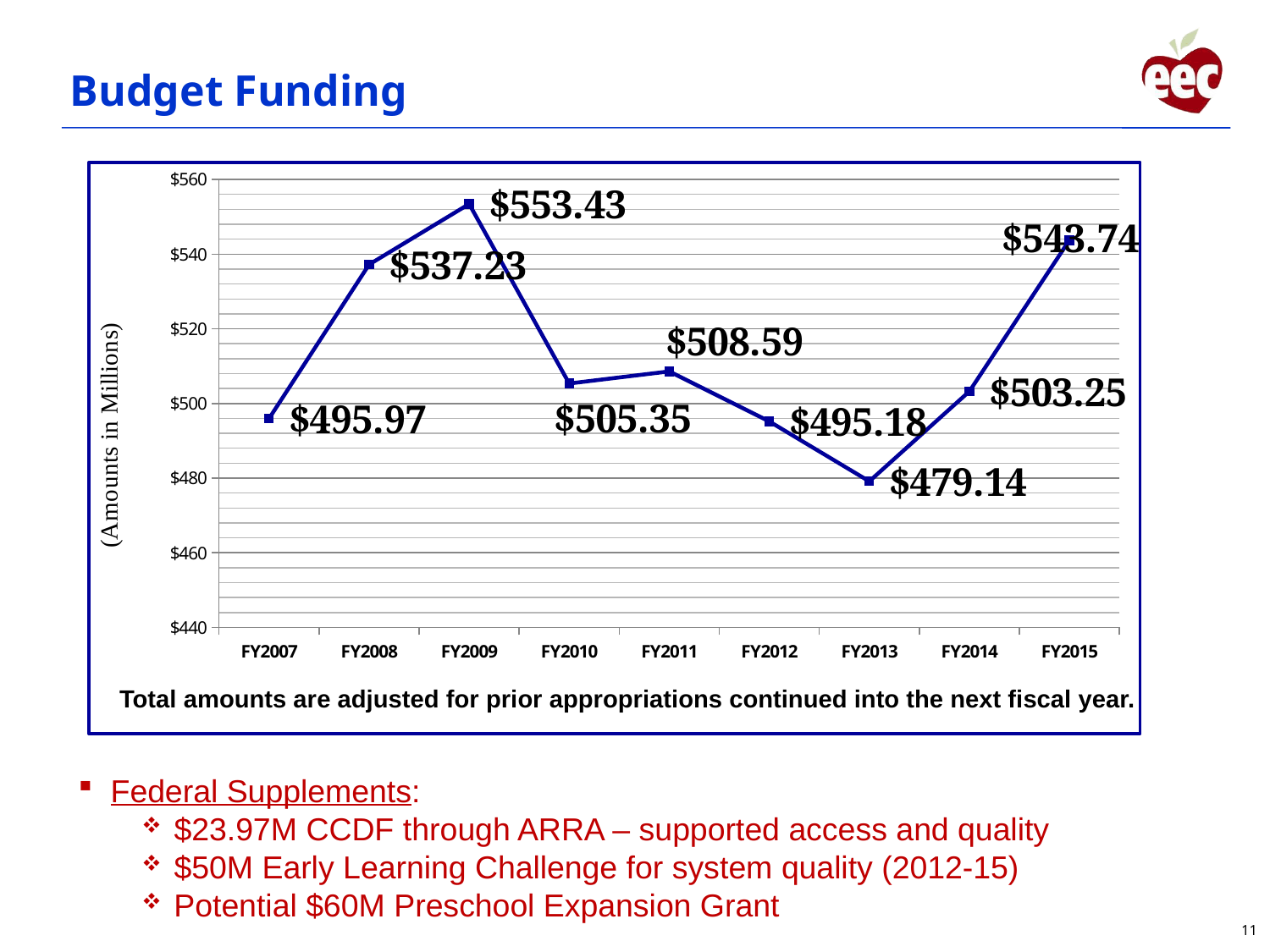
What is the difference between the FY2009 and FY2008 values? $16.20 Do the values rise or fall from FY2009 to FY2013? fall How many fiscal years are plotted on the chart? 9 What is the budget funding value for FY2007? $495.97 Which fiscal year has the highest budget funding? FY2009 What is the budget funding value for FY2009? $553.43 Is the value for FY2015 greater or less than $540? greater What kind of chart is shown on the slide? line chart What is the budget funding value for FY2013? $479.14 Which is larger, the value for FY2010 or the value for FY2012? FY2010 What is the budget funding value for FY2011? $508.59 Which fiscal year has the lowest budget funding? FY2013